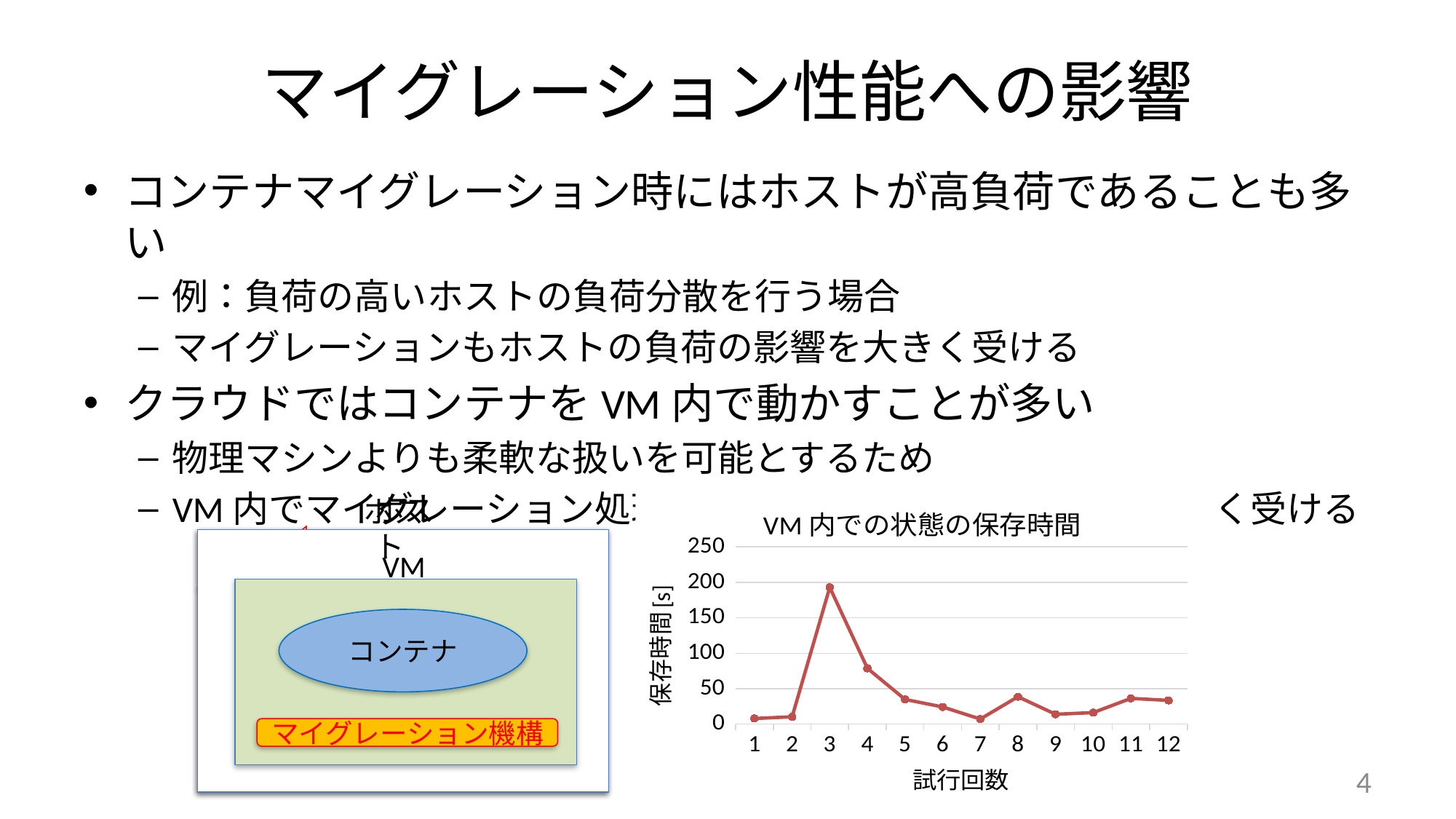
Which trial (試行回数) has the highest 保存時間? 3 Is the value for trial 3 greater or less than 150? greater How many data points are plotted on the chart? 12 What kind of chart is shown on the slide? line chart Which has the larger value, trial 3 or trial 4? trial 3 Which has the larger value, trial 7 or trial 8? trial 8 Do the values rise or fall from trial 3 to trial 7? fall What is the title of the chart? VM 内での状態の保存時間 Is the value for trial 4 greater or less than 50? greater What is the label of the x axis of the chart? 試行回数 Is the value for trial 4 greater or less than 100? less